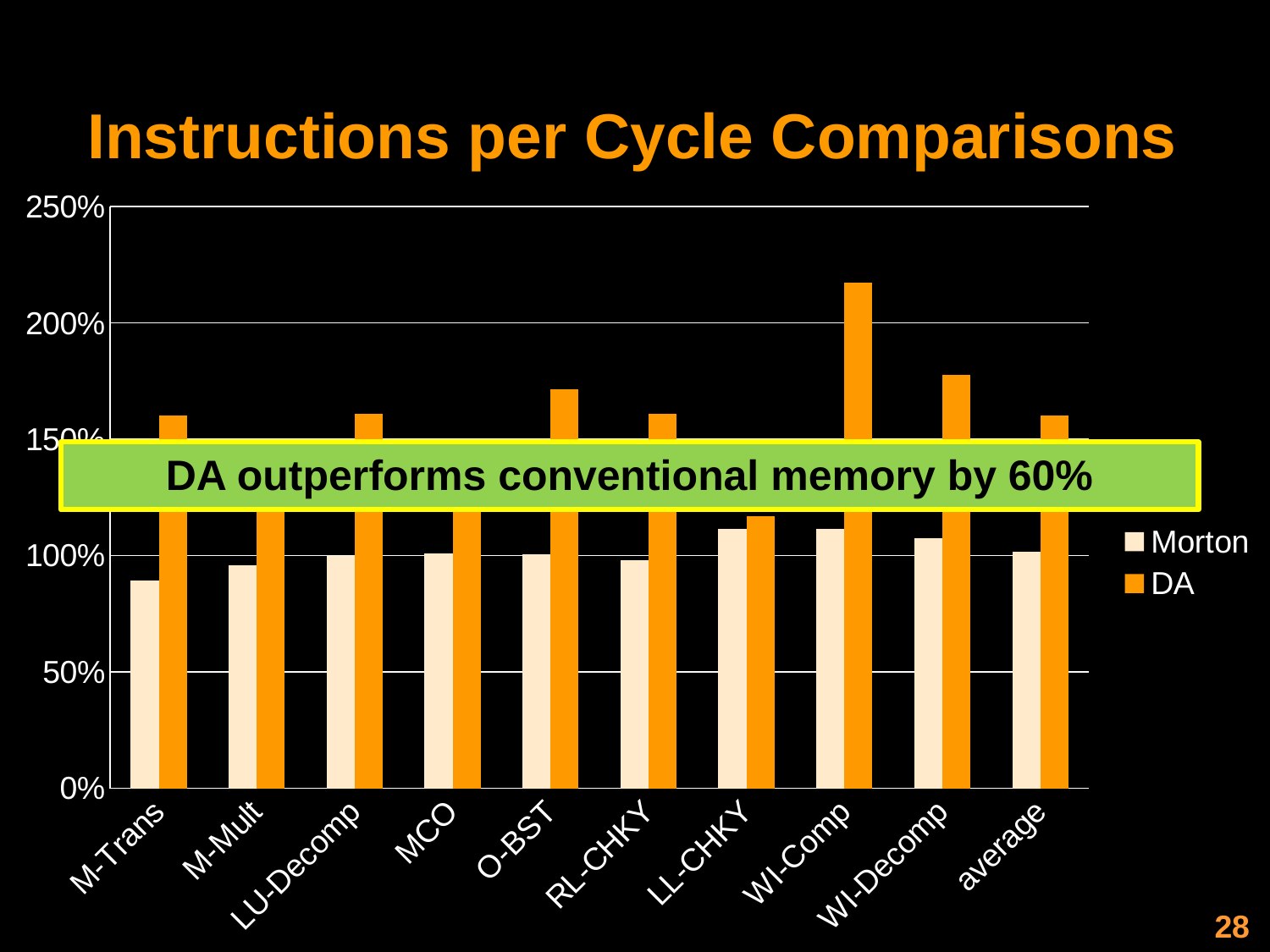
How many categories are shown along the x axis? 10 Which category has the lowest Morton value? M-Trans What is the title of the chart? Instructions per Cycle Comparisons Is the Morton value for WI-Comp greater or less than 100%? greater What kind of chart is shown on the slide? bar chart Is the DA value for WI-Comp greater or less than 200%? greater What are the two series named in the legend? Morton and DA Is the Morton value for M-Trans greater or less than 100%? less How many series does the legend list? 2 Which category has the highest DA value? WI-Comp For WI-Decomp, which series has the larger value, Morton or DA? DA